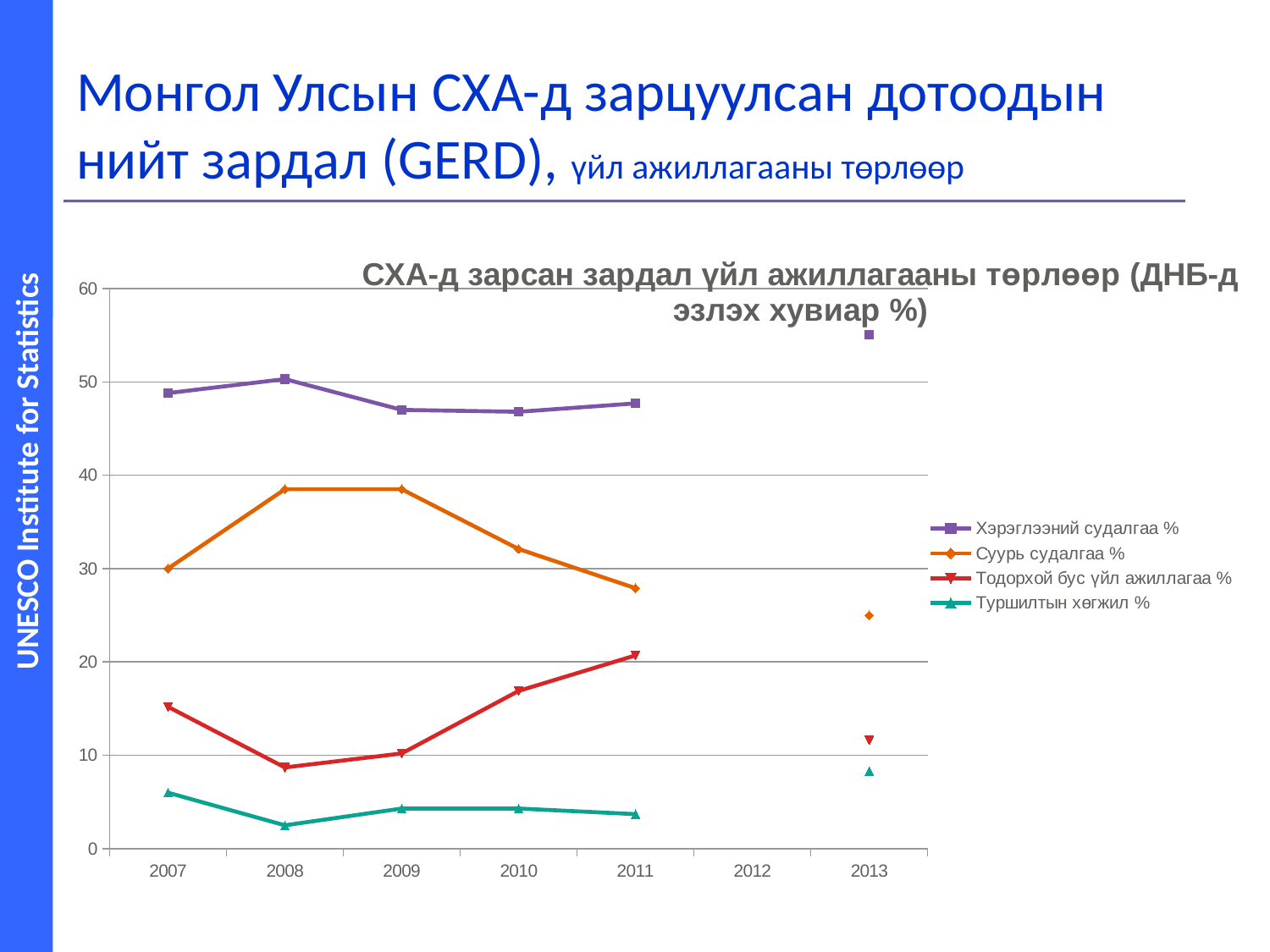
Does the Тодорхой бус үйл ажиллагаа % series rise or fall from 2008 to 2011? rise Is the value for Хэрэглээний судалгаа % in 2013 greater or less than 50? greater Which year on the x axis has no data points plotted? 2012 Is the value for Суурь судалгаа % in 2008 greater or less than 30? greater Which series has the lowest value in 2007? Туршилтын хөгжил % Which series has the highest value in 2011? Хэрэглээний судалгаа % How many years are shown on the x axis? 7 How many series does the legend list? 4 Does the Суурь судалгаа % series rise or fall from 2009 to 2011? fall Is the value for Тодорхой бус үйл ажиллагаа % in 2008 greater or less than 10? less For Суурь судалгаа %, which year has the larger value, 2009 or 2011? 2009 What kind of chart is shown on the slide? line chart